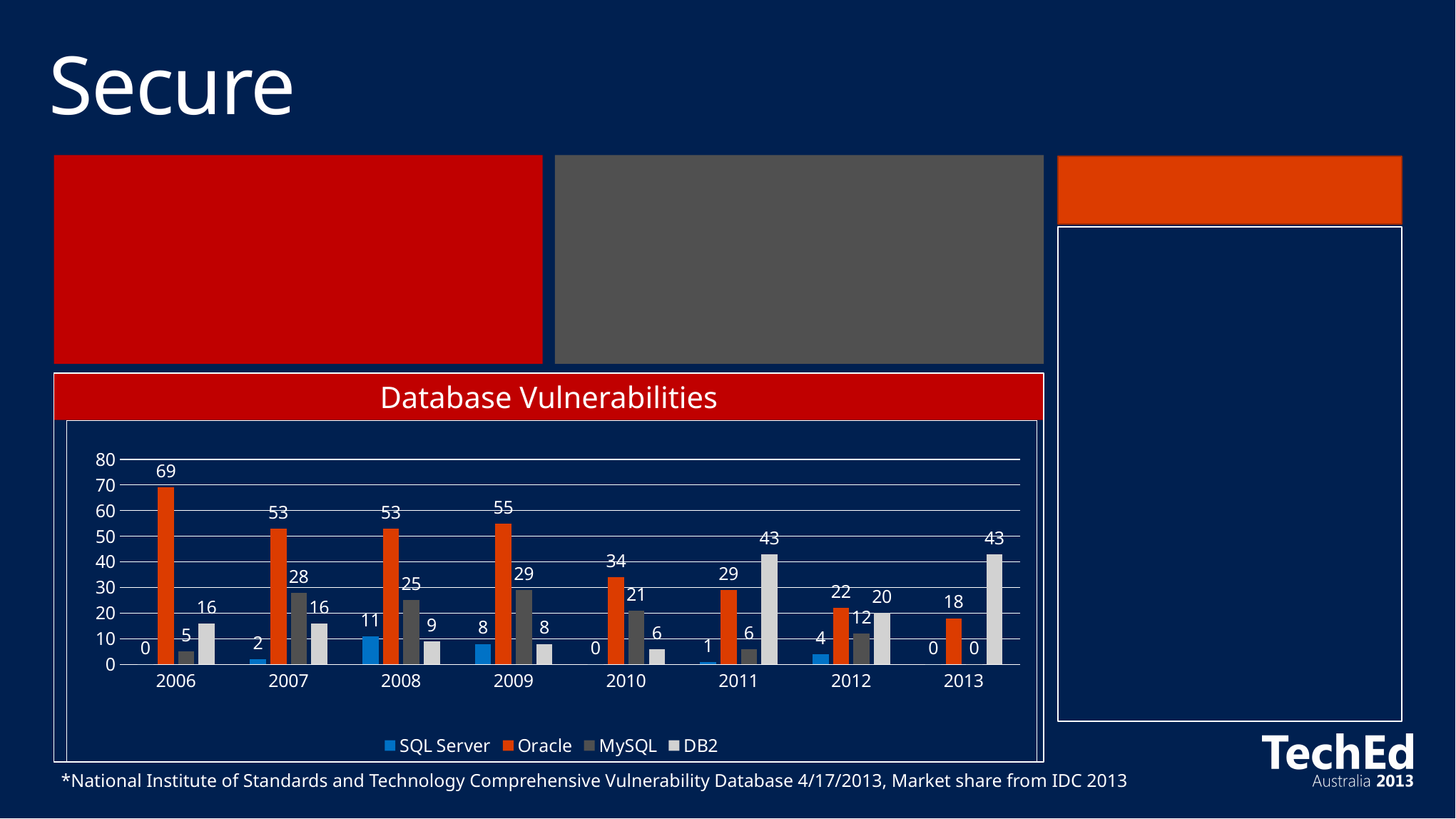
Does the Oracle value rise or fall from 2009 to 2013 in the Database Vulnerabilities chart? fall How many series does the legend of the Database Vulnerabilities chart list? 4 In 2011, which is larger in the Database Vulnerabilities chart: the Oracle value or the DB2 value? DB2 How many years are shown on the x axis of the Database Vulnerabilities chart? 8 What is the value for MySQL in 2009 in the Database Vulnerabilities chart? 29 What type of chart is shown under the title "Database Vulnerabilities"? bar chart In which year does Oracle have its highest value in the Database Vulnerabilities chart? 2006 What is the value for Oracle in 2006 in the Database Vulnerabilities chart? 69 What is the difference between the Oracle value and the MySQL value in 2010 in the Database Vulnerabilities chart? 13 What is the value for DB2 in 2013 in the Database Vulnerabilities chart? 43 Which series has the lowest value in 2012 in the Database Vulnerabilities chart? SQL Server What is the value for SQL Server in 2008 in the Database Vulnerabilities chart? 11